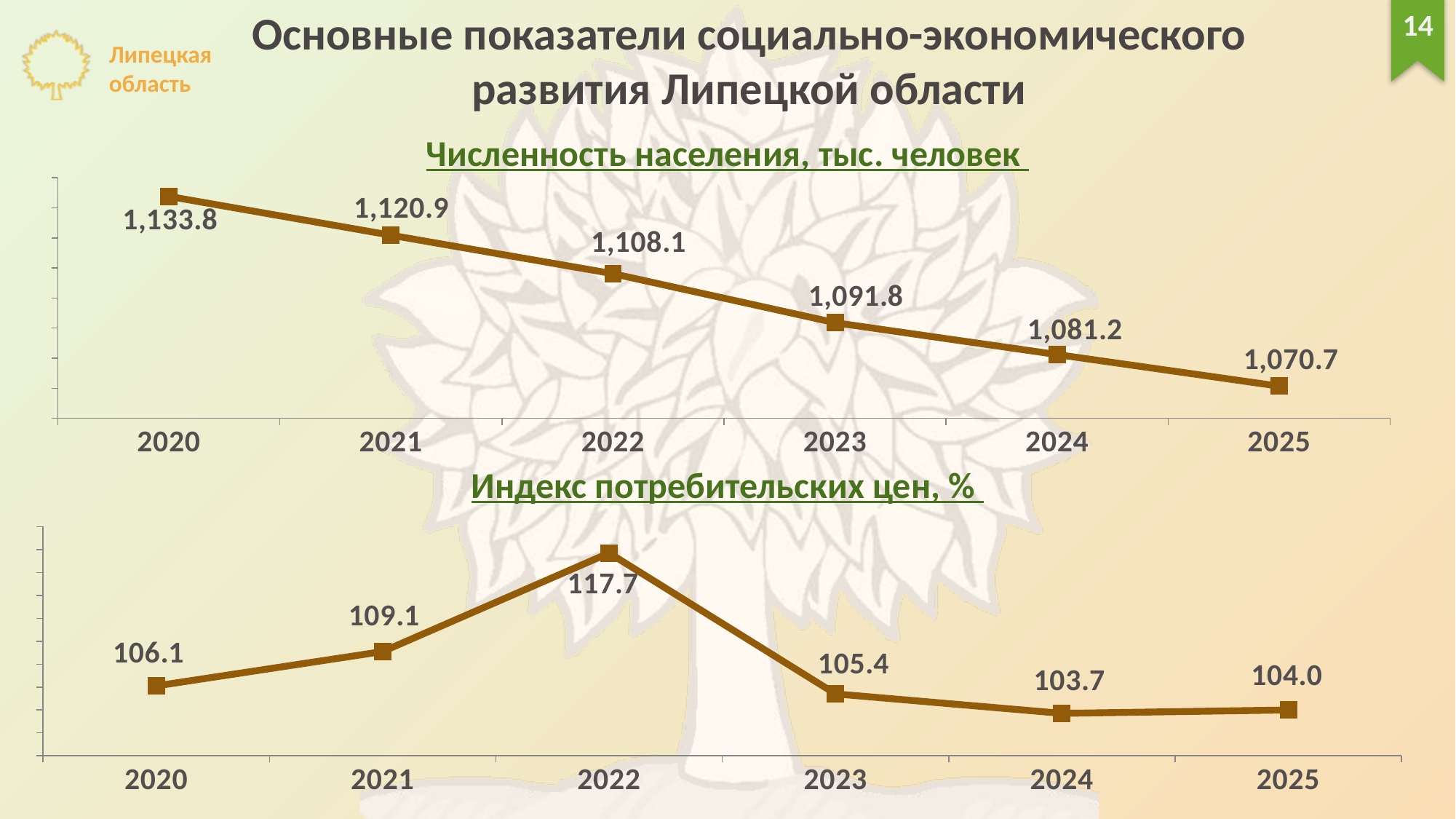
In the chart 'Численность населения, тыс. человек', what is the difference between the 2020 and 2025 values? 63.1 In the chart 'Индекс потребительских цен, %', which year has the lowest value? 2024 In the chart 'Численность населения, тыс. человек', what is the value for 2020? 1,133.8 In the chart 'Численность населения, тыс. человек', do the values rise or fall from 2020 to 2025? fall In the chart 'Численность населения, тыс. человек', which year has the lowest value? 2025 In the chart 'Индекс потребительских цен, %', which year has the highest value? 2022 In the chart 'Индекс потребительских цен, %', what is the value for 2022? 117.7 How many data points does the chart 'Численность населения, тыс. человек' show? 6 In the chart 'Индекс потребительских цен, %', what is the value for 2025? 104.0 In the chart 'Численность населения, тыс. человек', what is the value for 2023? 1,091.8 In the chart 'Индекс потребительских цен, %', what is the difference between the 2022 and 2021 values? 8.6 In the chart 'Индекс потребительских цен, %', which is larger, the value for 2020 or the value for 2023? 2020